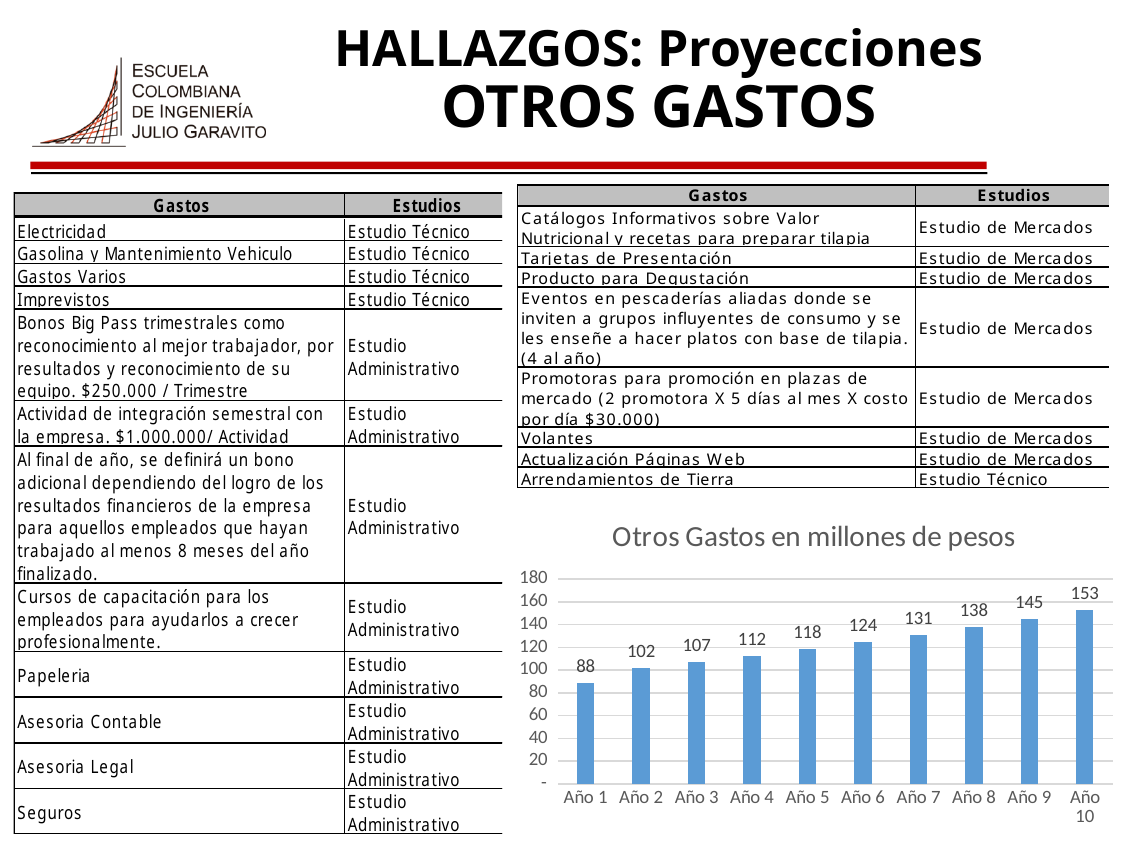
What is the difference between the values for Año 3 and Año 2 in the 'Otros Gastos en millones de pesos' chart? 5 Which year has the highest value in the 'Otros Gastos en millones de pesos' chart? Año 10 What is the value for Año 5 in the 'Otros Gastos en millones de pesos' chart? 118 Is the value for Año 8 greater or less than 120 in the 'Otros Gastos en millones de pesos' chart? greater Which year has the lowest value in the 'Otros Gastos en millones de pesos' chart? Año 1 What kind of chart is 'Otros Gastos en millones de pesos'? bar chart What is the difference between the values for Año 10 and Año 1 in the 'Otros Gastos en millones de pesos' chart? 65 How many years are shown on the x axis of the 'Otros Gastos en millones de pesos' chart? 10 Do the values in the 'Otros Gastos en millones de pesos' chart rise or fall from Año 1 to Año 10? rise What is the value for Año 10 in the 'Otros Gastos en millones de pesos' chart? 153 What is the value for Año 1 in the 'Otros Gastos en millones de pesos' chart? 88 Which is larger in the 'Otros Gastos en millones de pesos' chart, the value for Año 4 or Año 7? Año 7